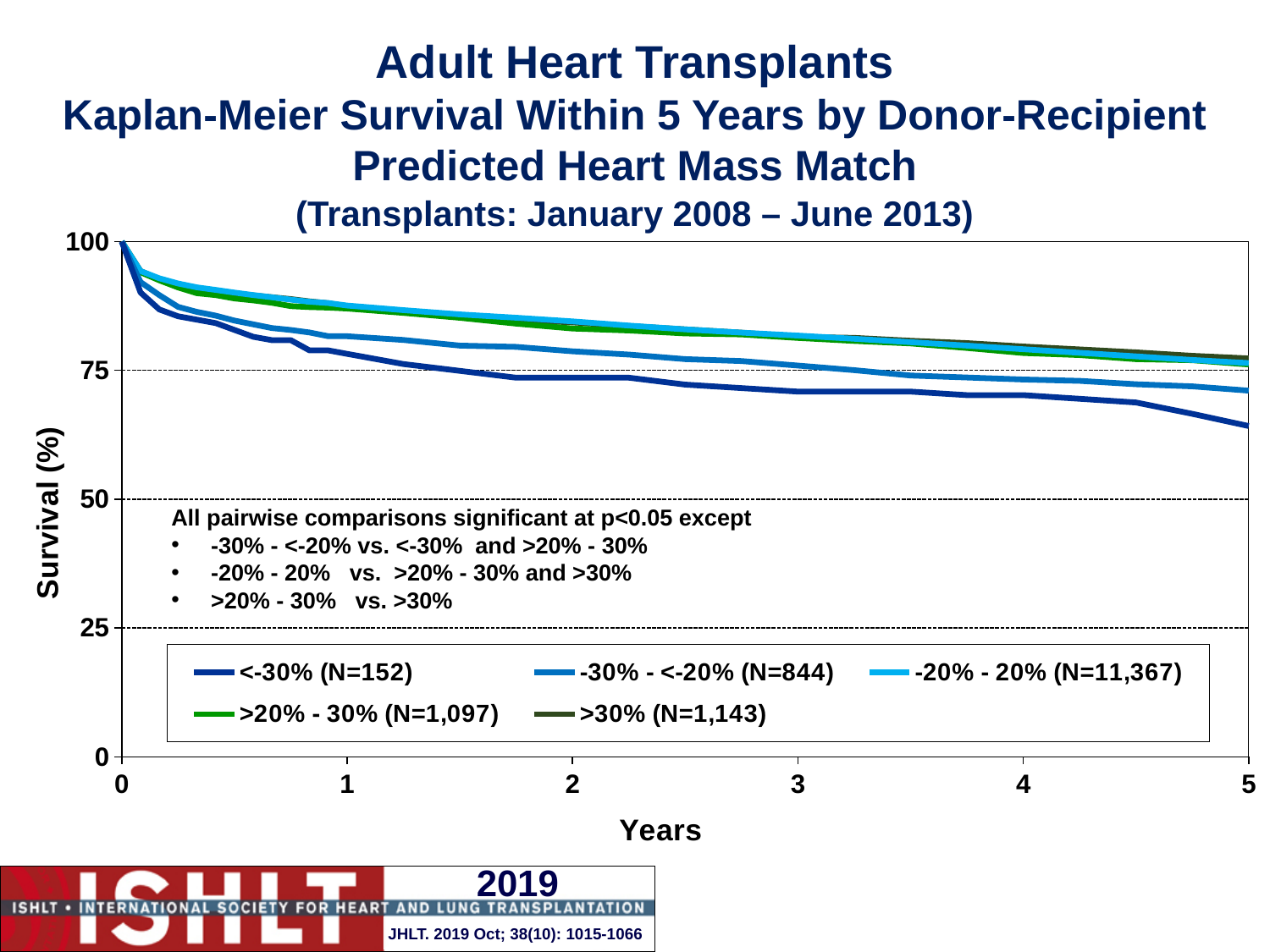
At 5 years, which group has higher survival: <-30% or -30% - <-20%? -30% - <-20% At 5 years, is the survival for the <-30% group greater or less than 50? greater What is the survival value for all groups at year 0? 100 At 3 years, is the survival for the -20% - 20% group greater or less than 75? greater Do the survival curves rise or fall as the years increase? fall How many series does the legend list? 5 What is the N for the -20% - 20% group in the legend? 11,367 What is the N for the <-30% group in the legend? 152 Which group has the lowest survival at 5 years? <-30% (N=152) At 5 years, is the survival for the <-30% group greater or less than 75? less What kind of chart is shown on the slide? line chart